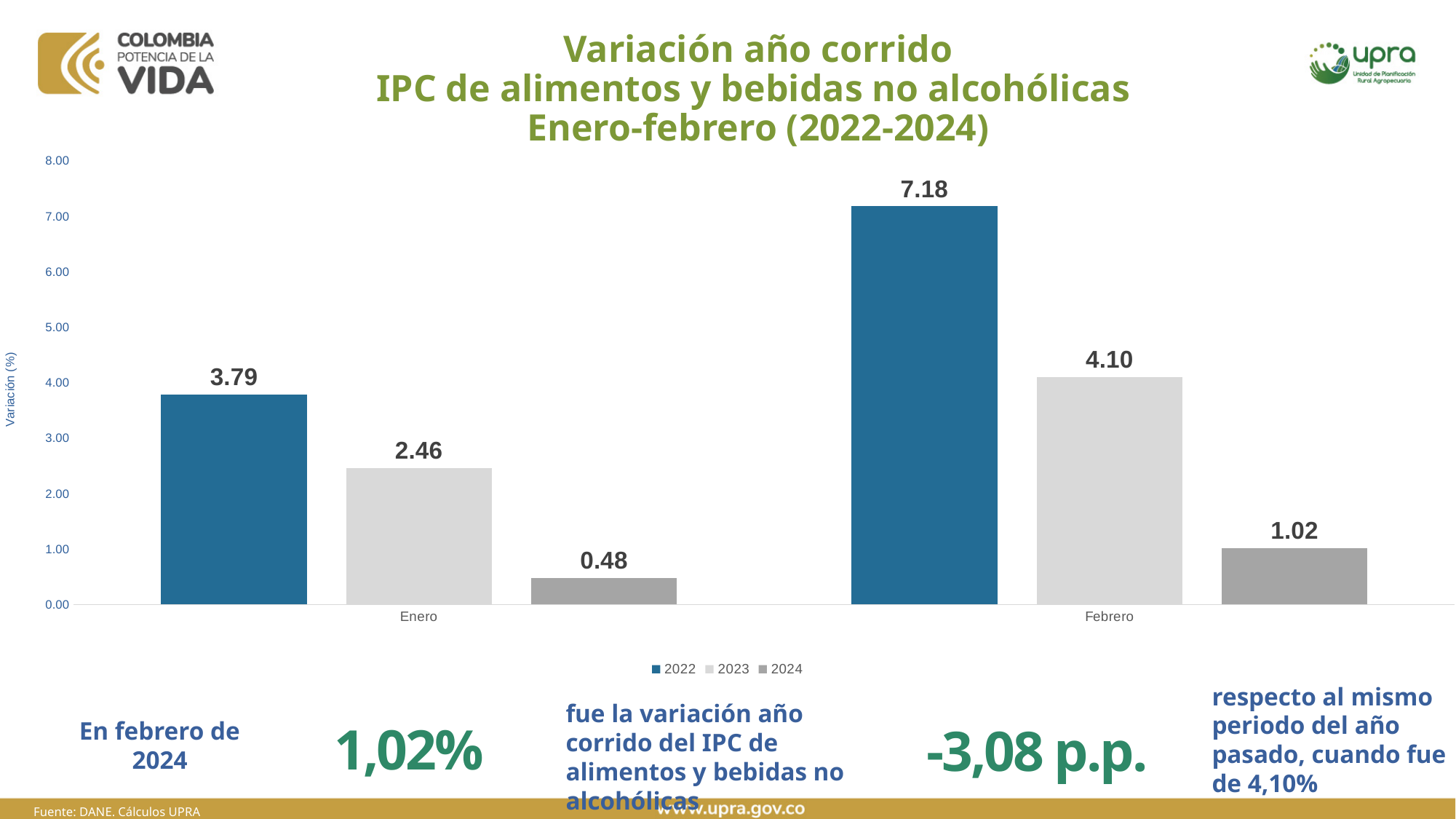
What is the value for 2022 in Enero? 3.79 What is the value for 2024 in Febrero? 1.02 What is the difference between the 2023 and 2024 values in Febrero? 3.08 What is the value for 2023 in Febrero? 4.10 What is the difference between the 2022 values for Febrero and Enero? 3.39 Which is larger, the 2023 value in Enero or the 2024 value in Febrero? 2023 value in Enero Which series has the highest value in Febrero? 2022 What kind of chart is shown on the slide? Bar chart Which series has the lowest value in Enero? 2024 How many categories are shown on the x axis? 2 How many series does the legend list? 3 What is the label of the y axis? Variación (%)